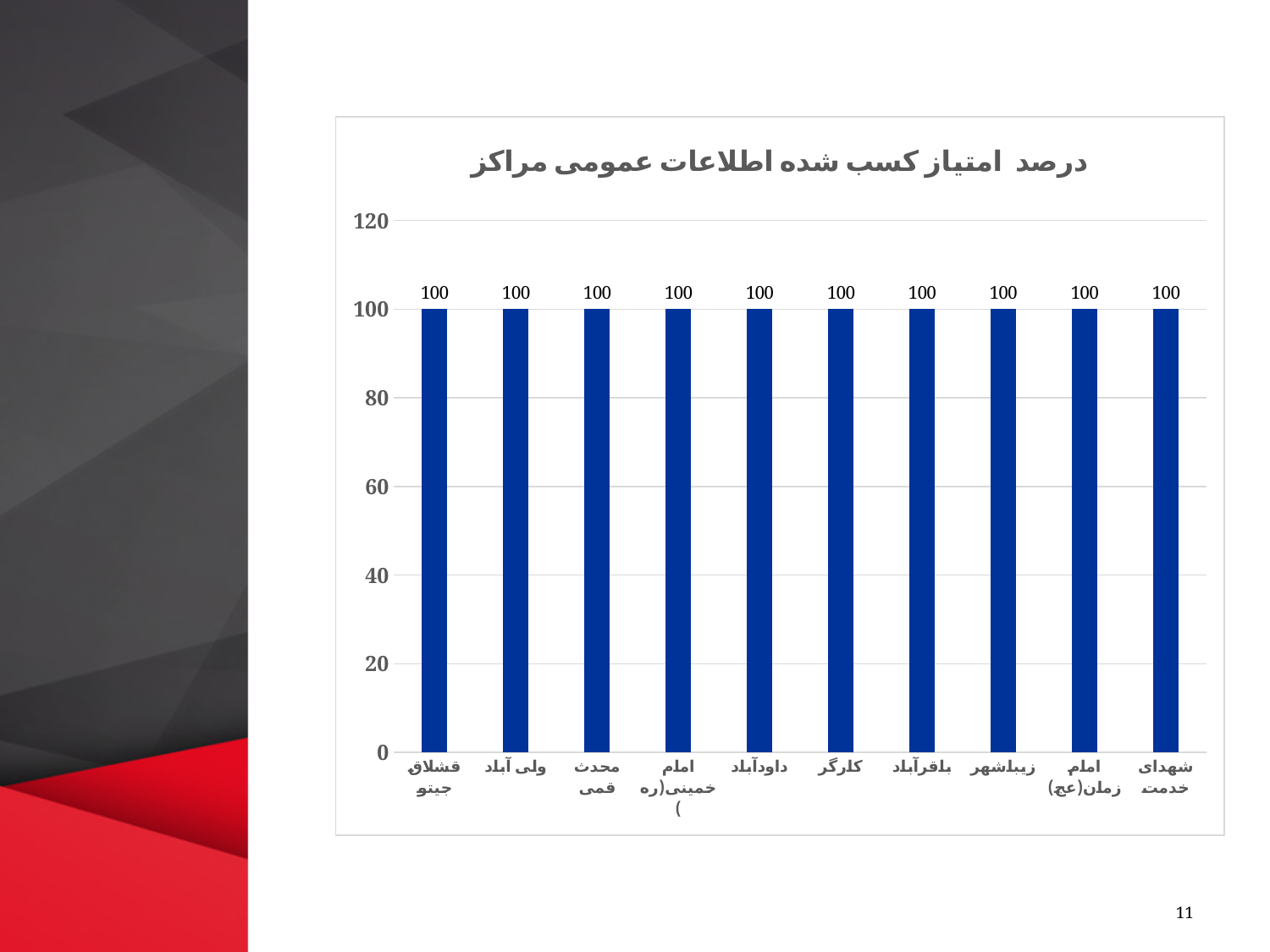
Do the values rise, fall, or stay the same across the categories? stay the same What is the value for قشلاق جیتو? 100 Is the value for ولی آباد greater or less than 80? greater What is the value for شهدای خدمت? 100 What is the value for زیباشهر? 100 What is the difference between the values for باقرآباد and داودآباد? 0 Is the value for محدث قمی greater or less than 120? less What is the title of the chart? درصد امتیاز کسب شده اطلاعات عمومی مراکز What colour are the bars in the chart? blue What is the value for کارگر? 100 How many categories are shown on the x axis? 10 What kind of chart is shown on the slide? bar chart